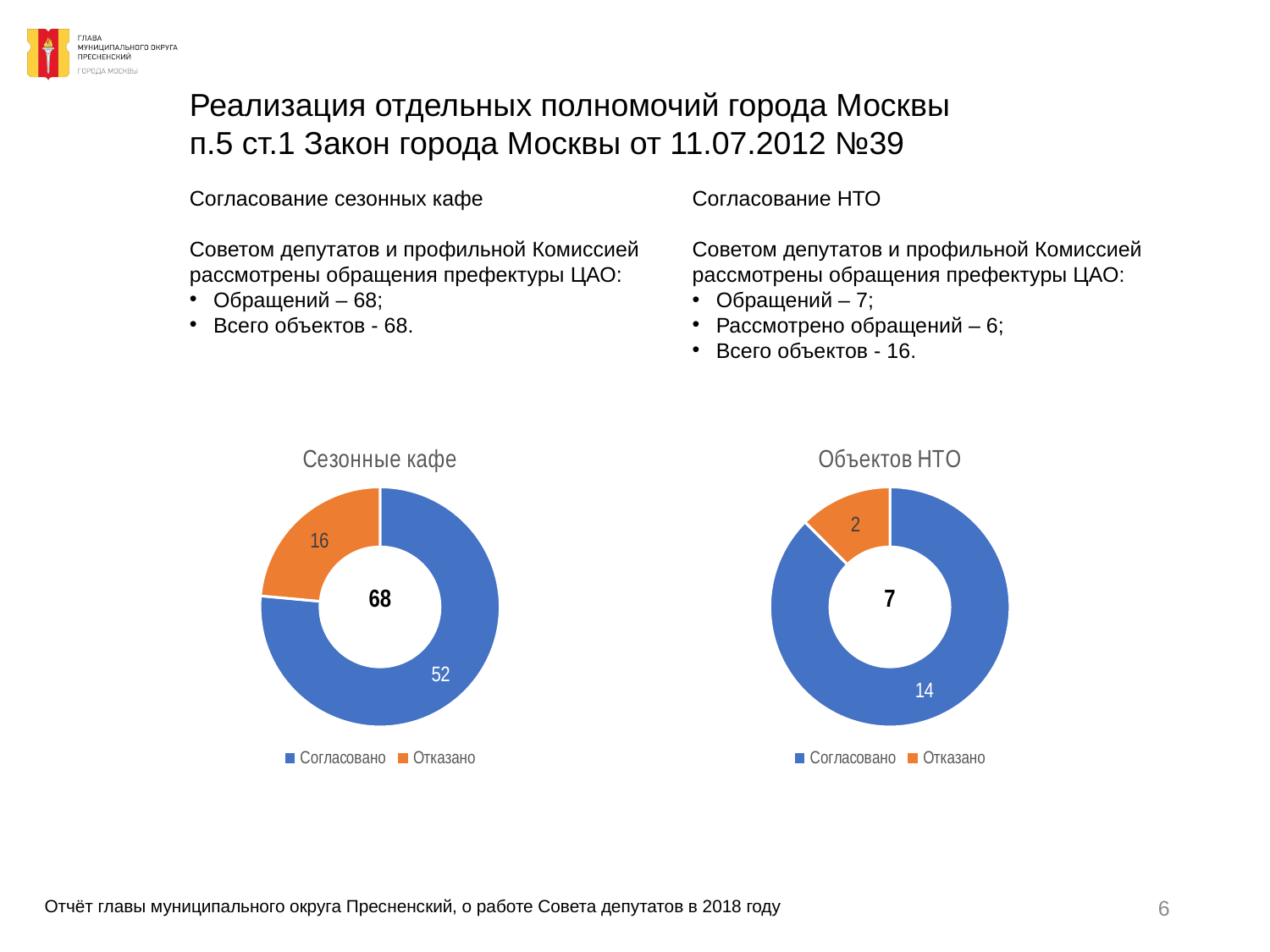
In the 'Сезонные кафе' chart, what is the value for 'Согласовано'? 52 In the 'Сезонные кафе' chart, which category has the largest slice? Согласовано What number is printed in the centre of the 'Сезонные кафе' chart? 68 In the 'Объектов НТО' chart, what share of the total do the 'Отказано' objects represent? 12.5% In the 'Сезонные кафе' chart, what is the difference between 'Согласовано' and 'Отказано'? 36 In the 'Объектов НТО' chart, which category has the smallest slice? Отказано How many categories does the legend of the 'Объектов НТО' chart list? 2 In the 'Объектов НТО' chart, what is the difference between 'Согласовано' and 'Отказано'? 12 In the 'Сезонные кафе' chart, what is the value for 'Отказано'? 16 In the 'Объектов НТО' chart, what is the value for 'Согласовано'? 14 What type of chart is the 'Сезонные кафе' chart? Donut (pie) chart In the 'Объектов НТО' chart, what is the value for 'Отказано'? 2